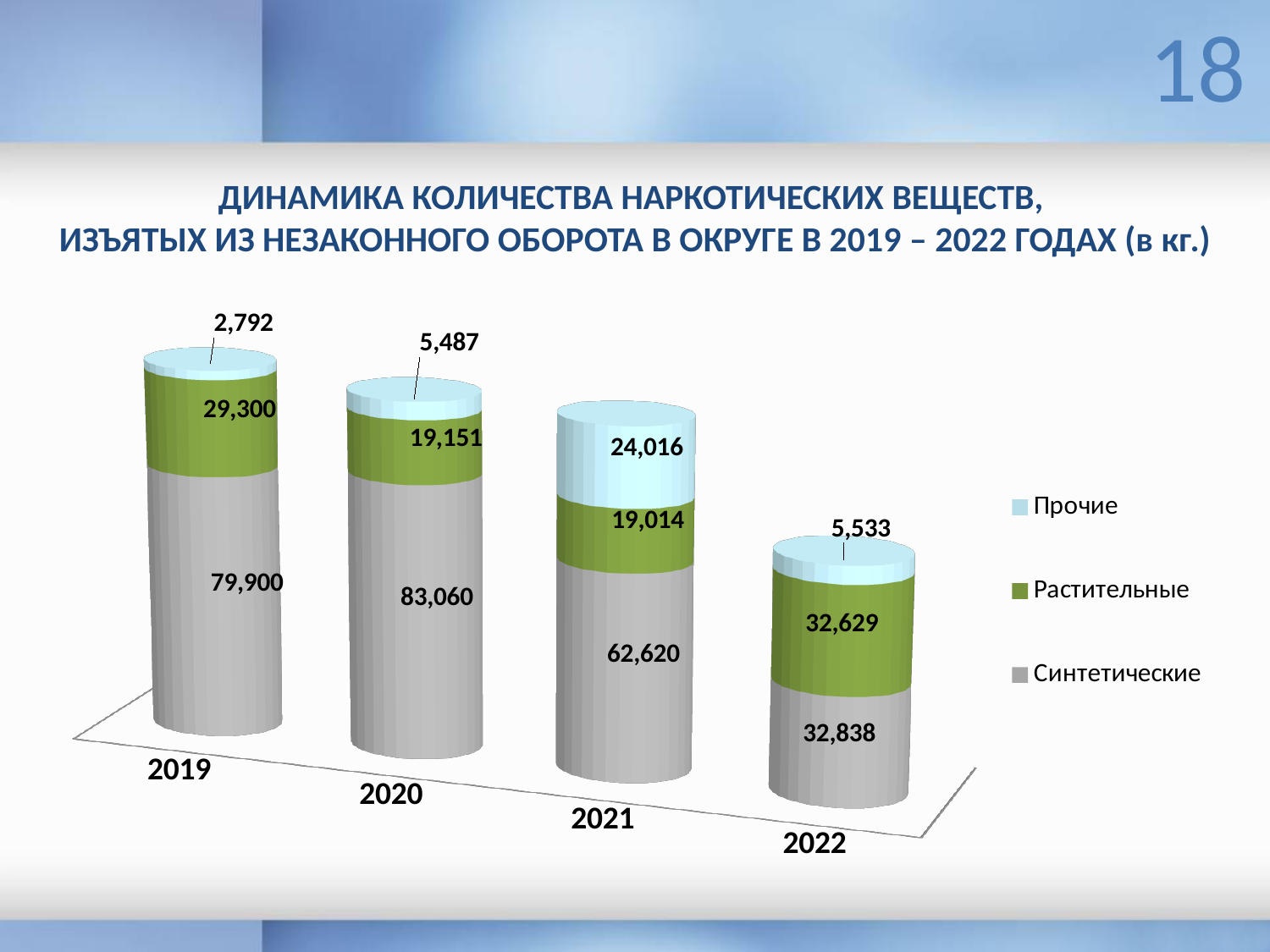
What is the value for Синтетические in 2019? 79,900 Which series is shown in green in the legend? Растительные What is the difference between Синтетические and Растительные in 2019? 50,600 What is the value for Прочие in 2021? 24,016 How many series does the legend list? 3 In which year is the value for Синтетические the highest? 2020 What kind of chart is shown on the slide? stacked bar chart How many years are shown on the x axis? 4 What is the total of the stacked bar for 2019? 111,992 Which is larger in 2022: Синтетические or Растительные? Синтетические In which year is the value for Прочие the lowest? 2019 What is the value for Растительные in 2022? 32,629